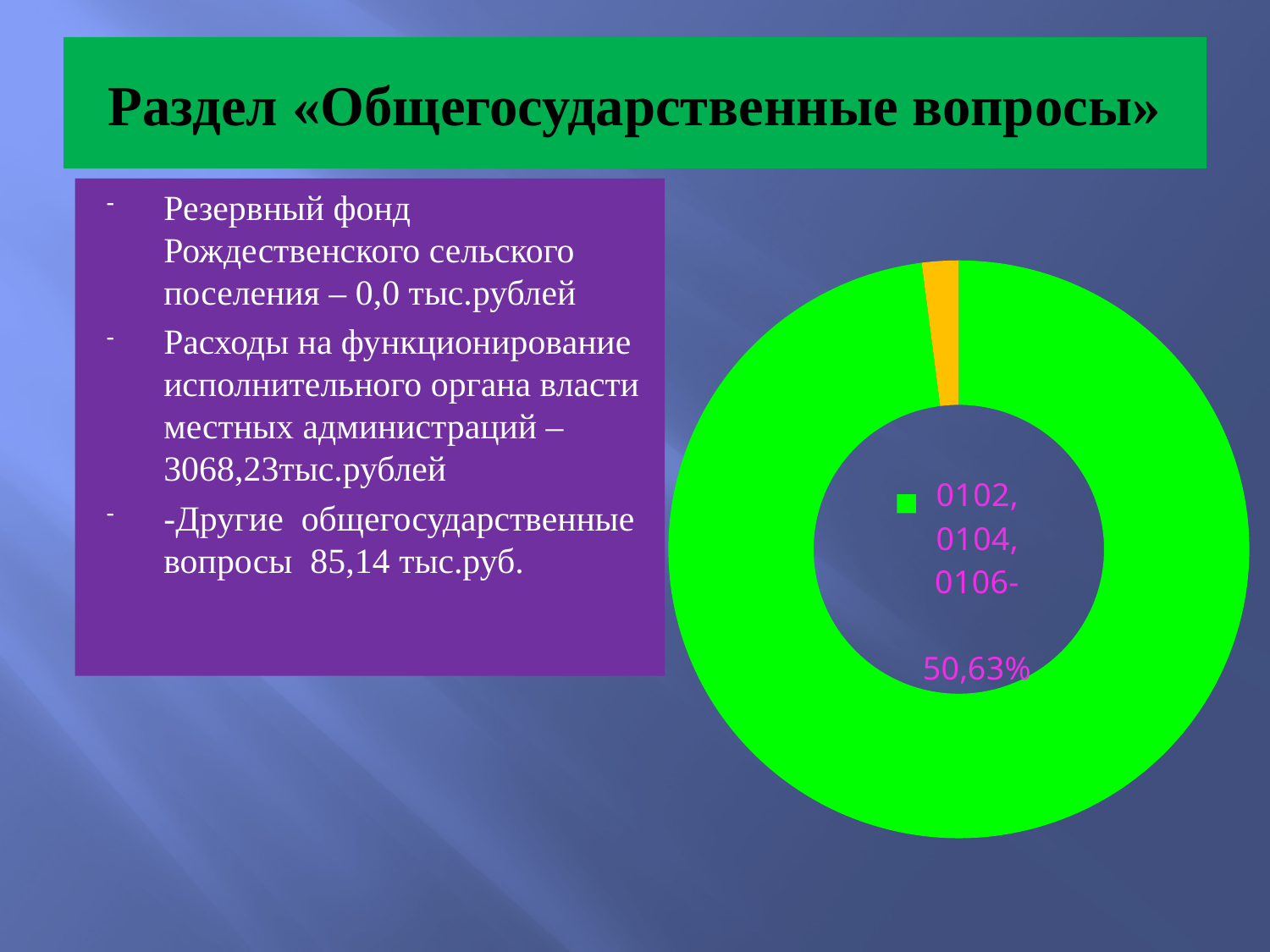
Which slice of the doughnut chart is the smallest? the orange slice How many slices does the doughnut chart have? 2 What kind of chart is shown on the slide? doughnut (pie) chart What colour is the largest slice of the doughnut chart? green Which slice of the doughnut chart is larger, the green one or the orange one? the green one